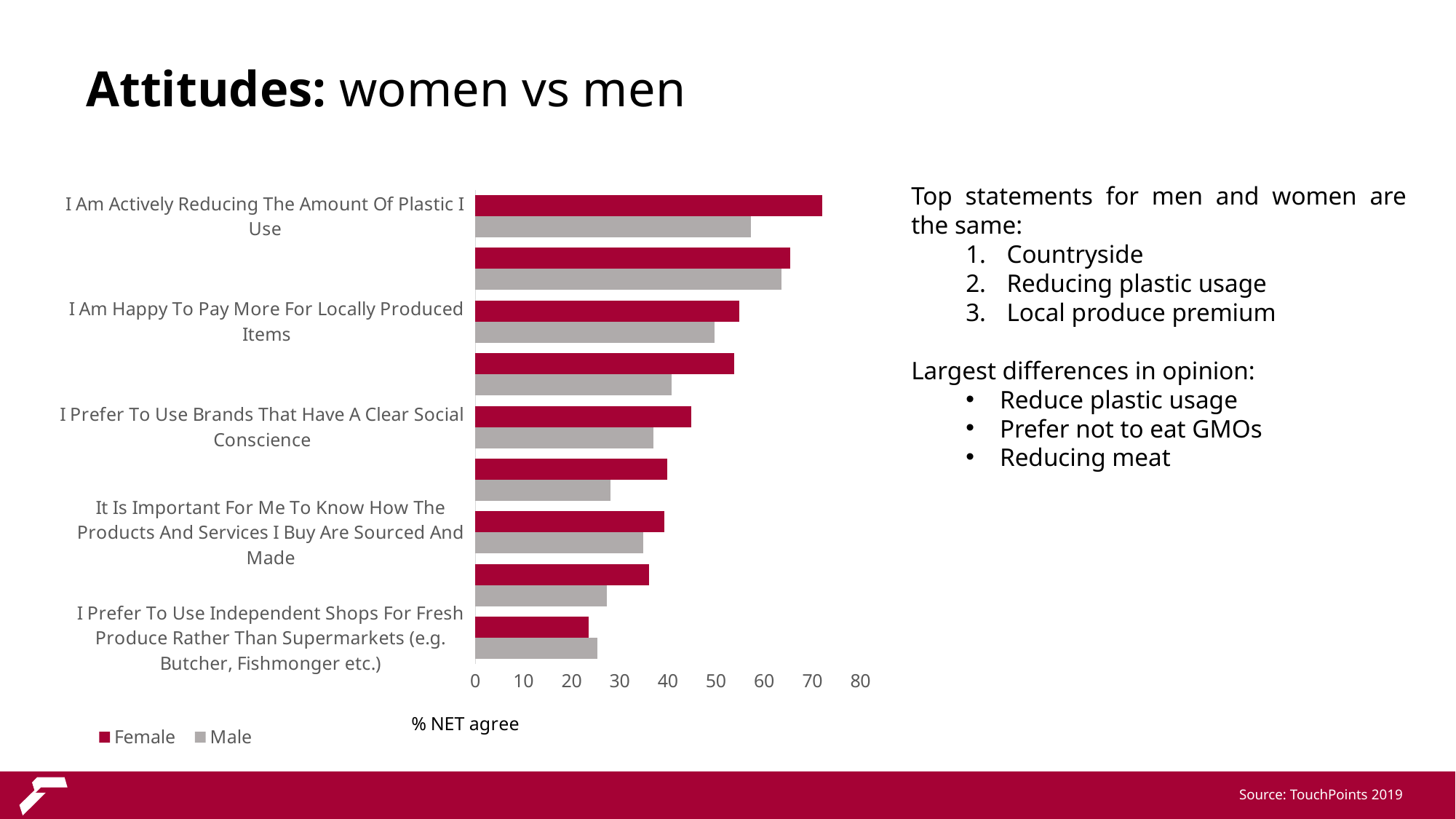
Is the Male value for 'I Prefer To Use Brands That Have A Clear Social Conscience' greater or less than 40? less How many series does the chart legend list? 2 What are the two series named in the chart legend? Female and Male Is the Male value for 'I Am Actively Reducing The Amount Of Plastic I Use' greater or less than 50? greater For 'I Am Happy To Pay More For Locally Produced Items', which is larger, the Female value or the Male value? Female Is the Female value for 'I Am Actively Reducing The Amount Of Plastic I Use' greater or less than 60? greater Which labelled statement has the lowest Female value in the chart? I Prefer To Use Independent Shops For Fresh Produce Rather Than Supermarkets (e.g. Butcher, Fishmonger etc.) What kind of chart is shown on the slide? Bar chart For 'I Prefer To Use Independent Shops For Fresh Produce Rather Than Supermarkets', which is larger, the Female value or the Male value? Male What is the label on the chart's horizontal axis? % NET agree Which statement has the highest Female value in the chart? I Am Actively Reducing The Amount Of Plastic I Use